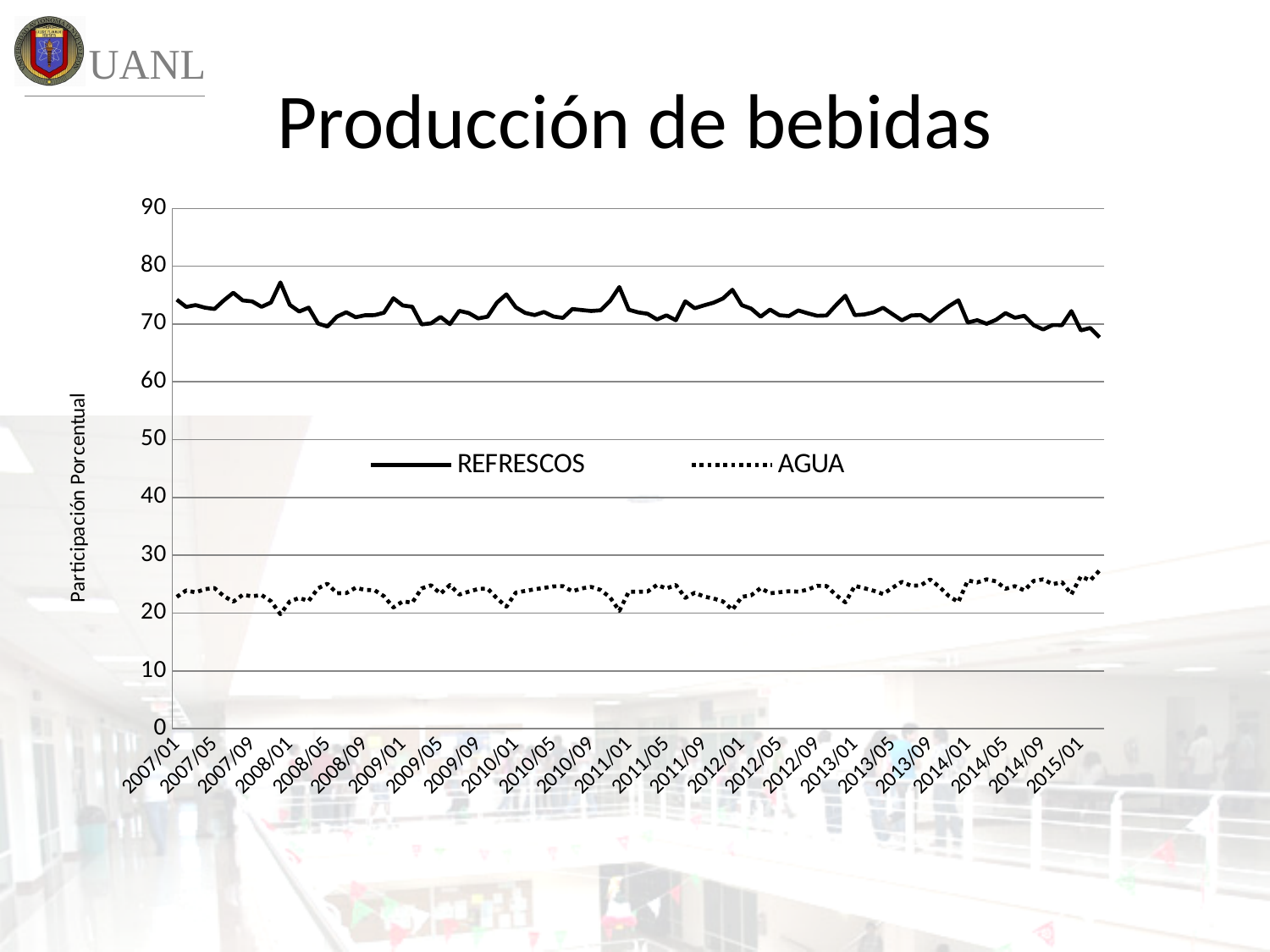
What kind of chart is shown on the slide? line chart What is the title of the chart? Producción de bebidas Overall, does the REFRESCOS series end higher or lower in 2015 than it started in 2007? lower Is the value for REFRESCOS at 2015/01 greater or less than 60? greater Is the value for REFRESCOS at 2007/01 greater or less than 70? greater Which series has the higher values throughout the chart, REFRESCOS or AGUA? REFRESCOS Is the value for AGUA at 2015/01 greater or less than 20? greater What are the two series named in the legend? REFRESCOS and AGUA How many series does the legend list? 2